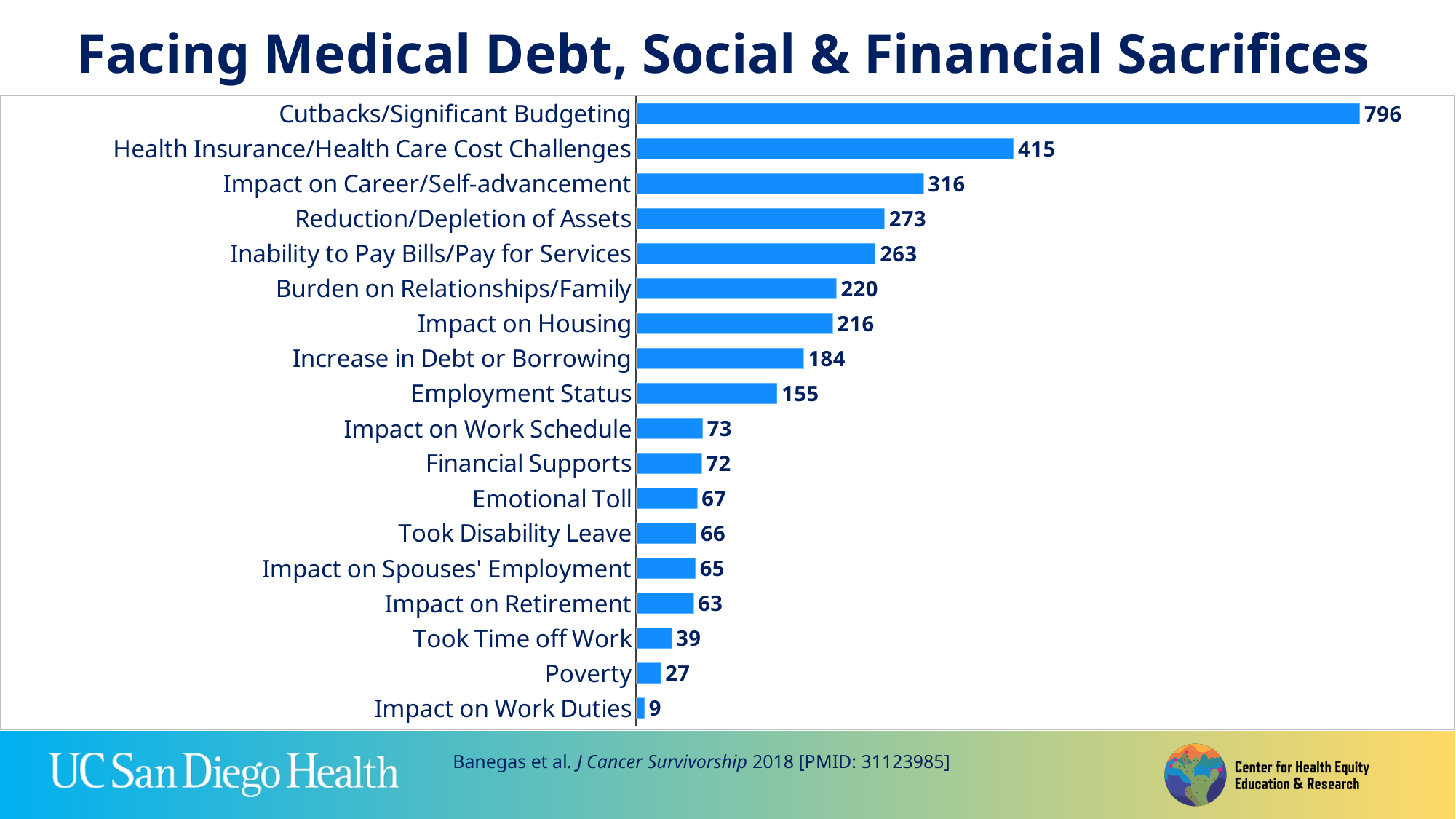
What kind of chart is shown on the slide? Bar chart What is the value for Cutbacks/Significant Budgeting? 796 What is the value for Took Time off Work? 39 Which is larger, the value for Poverty or the value for Took Time off Work? Took Time off Work What is the difference between the values for Cutbacks/Significant Budgeting and Health Insurance/Health Care Cost Challenges? 381 What is the value for Increase in Debt or Borrowing? 184 Which is larger, the value for Impact on Career/Self-advancement or the value for Reduction/Depletion of Assets? Impact on Career/Self-advancement How many categories are shown in the chart? 18 Which category has the highest value? Cutbacks/Significant Budgeting Which category has the lowest value? Impact on Work Duties What is the difference between the values for Employment Status and Impact on Work Schedule? 82 What is the title of the slide? Facing Medical Debt, Social & Financial Sacrifices